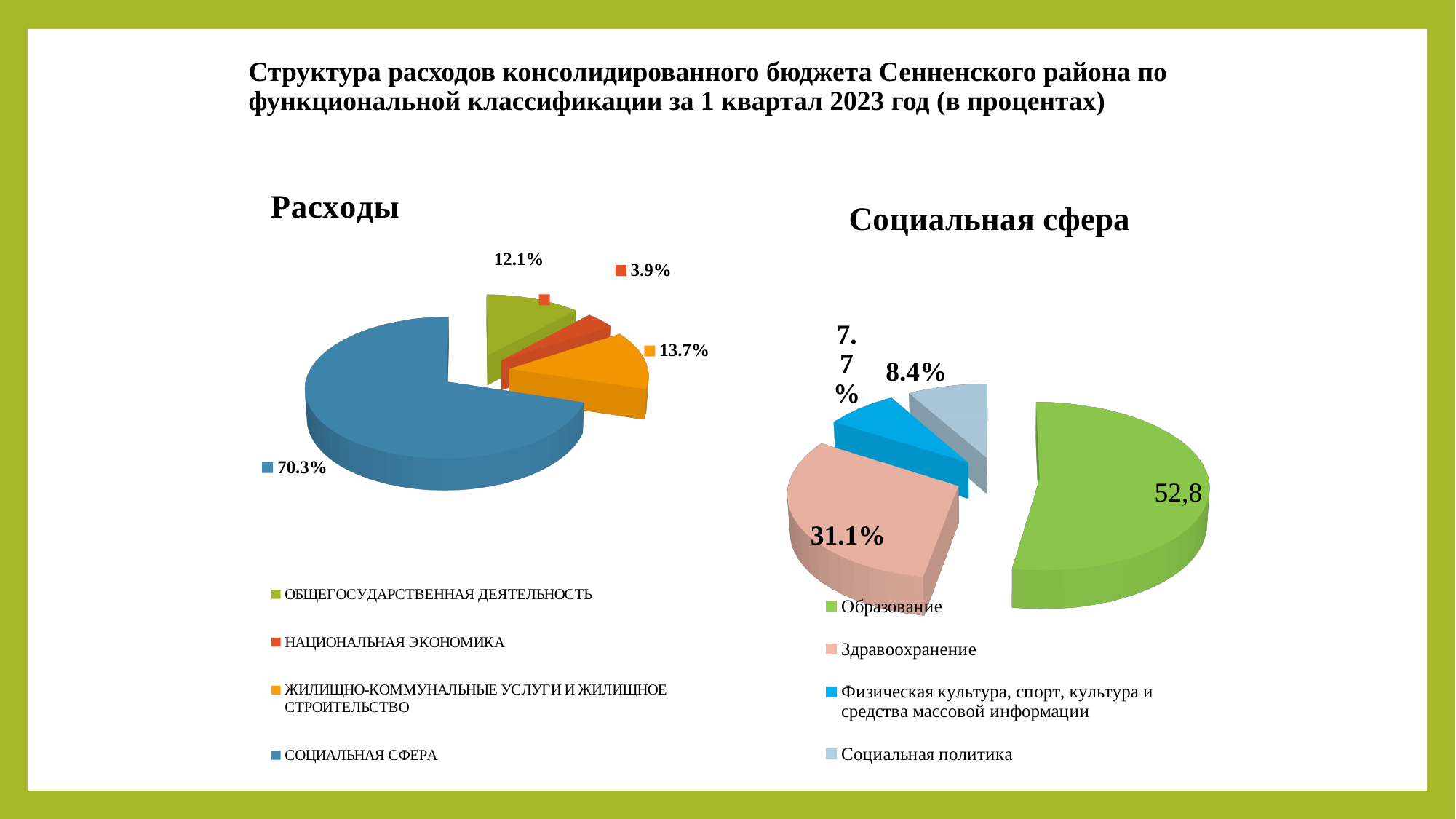
In the "Социальная сфера" pie chart, which is larger: Социальная политика or Физическая культура, спорт, культура и средства массовой информации? Социальная политика In the "Социальная сфера" pie chart, what is the value for Социальная политика? 8.4% In the "Расходы" pie chart, how many categories are shown? 4 In the "Социальная сфера" pie chart, what is the value for Образование? 52,8 What type of chart is the "Социальная сфера" chart? Pie chart In the "Социальная сфера" pie chart, which category has the largest share? Образование In the "Расходы" pie chart, what is the value for ЖИЛИЩНО-КОММУНАЛЬНЫЕ УСЛУГИ И ЖИЛИЩНОЕ СТРОИТЕЛЬСТВО? 13.7% In the "Социальная сфера" pie chart, what is the value for Здравоохранение? 31.1% In the "Расходы" pie chart, what is the value for НАЦИОНАЛЬНАЯ ЭКОНОМИКА? 3.9% In the "Расходы" pie chart, what is the value for СОЦИАЛЬНАЯ СФЕРА? 70.3% In the "Расходы" pie chart, what is the difference between the values for ЖИЛИЩНО-КОММУНАЛЬНЫЕ УСЛУГИ И ЖИЛИЩНОЕ СТРОИТЕЛЬСТВО and ОБЩЕГОСУДАРСТВЕННАЯ ДЕЯТЕЛЬНОСТЬ? 1.6% In the "Расходы" pie chart, which category has the smallest share? НАЦИОНАЛЬНАЯ ЭКОНОМИКА